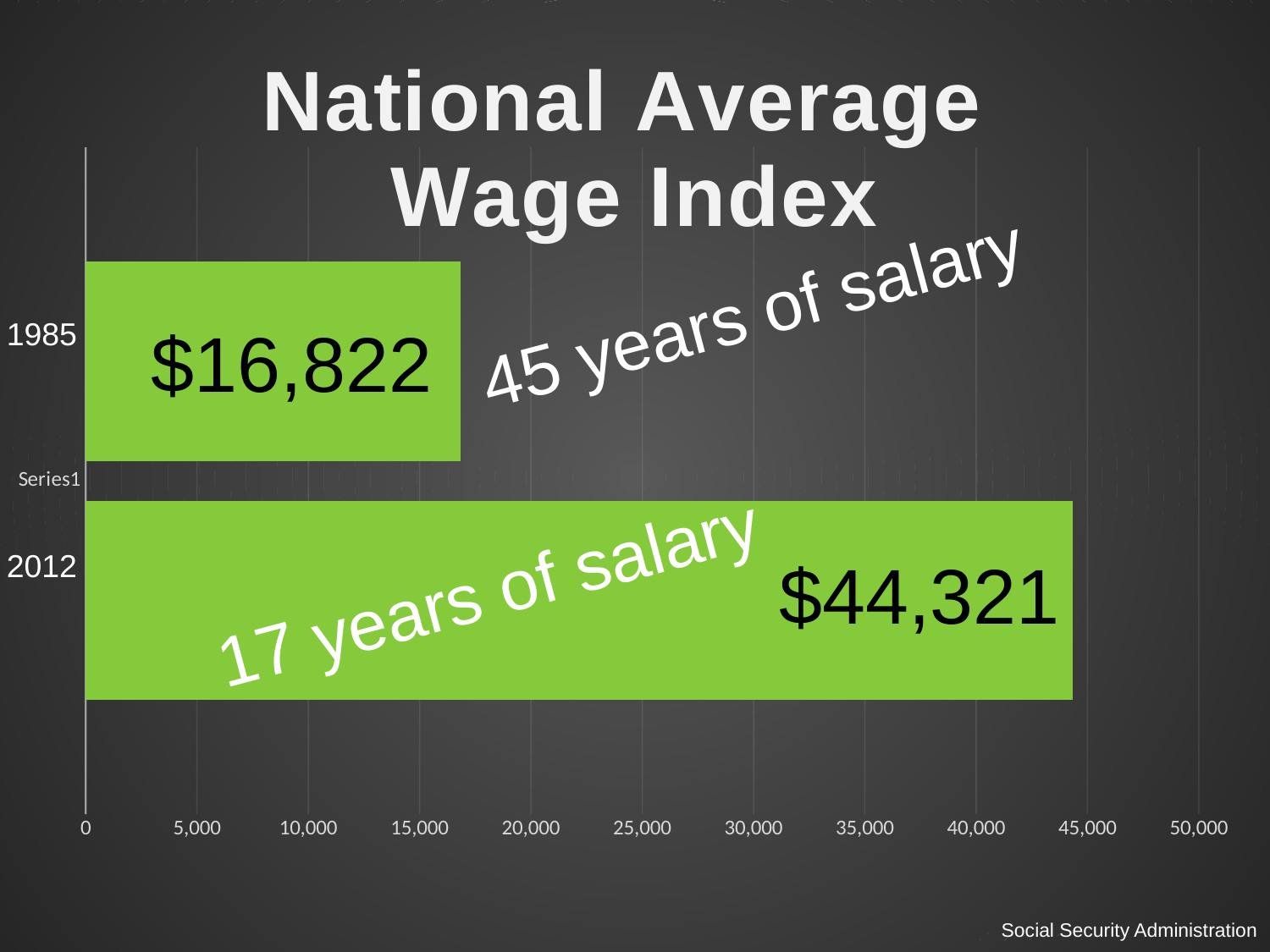
Is the value for 1985 greater or less than 20,000? less Is the value for 2012 larger or smaller than the value for 1985? larger Which year has the higher National Average Wage Index value? 2012 What kind of chart is shown on the slide? bar chart What is the National Average Wage Index value shown for 2012? $44,321 Is the value for 2012 greater or less than 40,000? greater What is the difference between the 2012 and 1985 National Average Wage Index values? $27,499 How many years (categories) are plotted in the chart? 2 What is the National Average Wage Index value shown for 1985? $16,822 Which year has the lower National Average Wage Index value? 1985 What is the title of the chart? National Average Wage Index What source is credited at the bottom of the slide? Social Security Administration